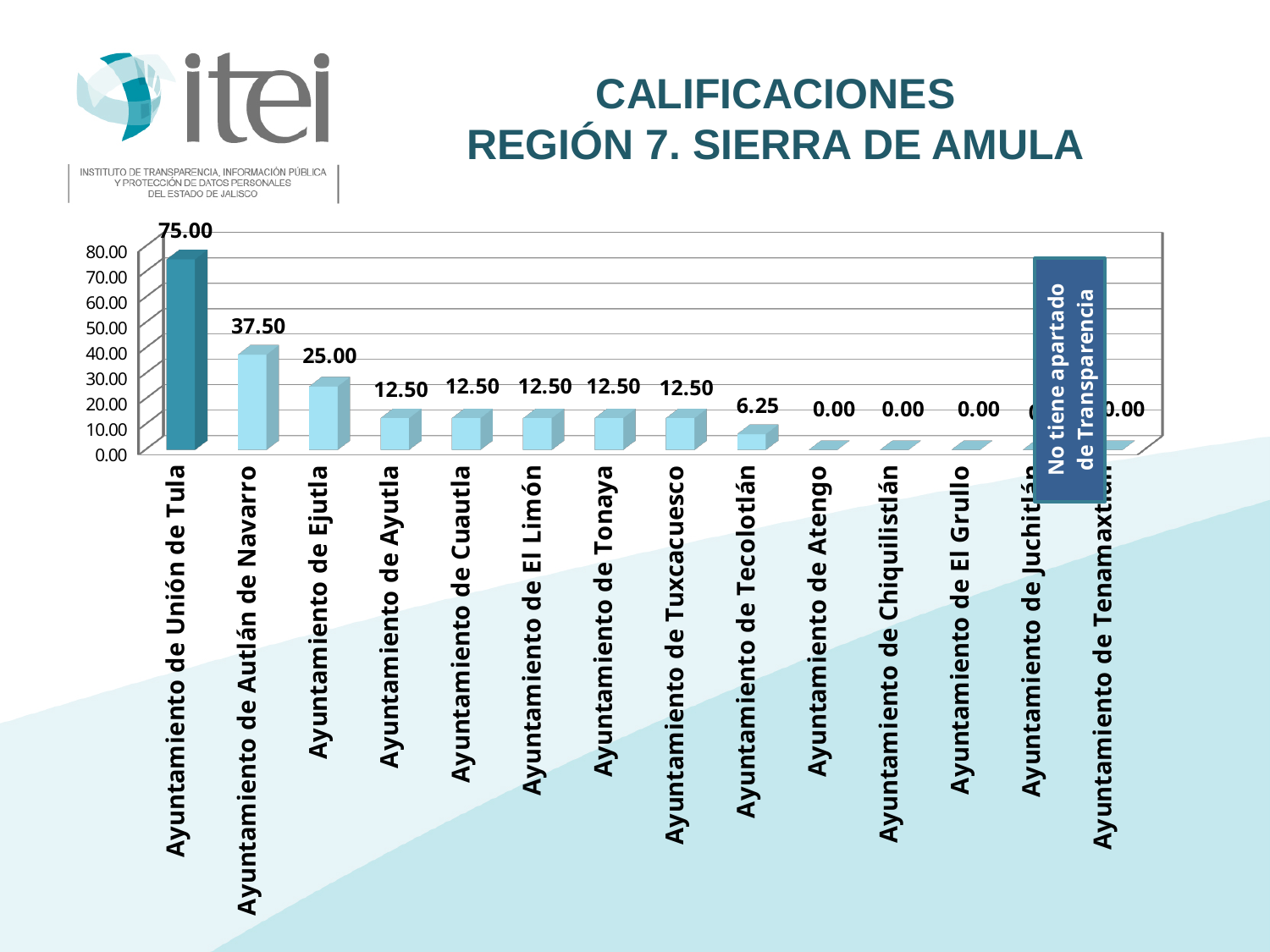
Which municipality has the highest value? Ayuntamiento de Unión de Tula What is the value for Ayuntamiento de Unión de Tula? 75.00 What is the value for Ayuntamiento de Atengo? 0.00 What is the value for Ayuntamiento de Ejutla? 25.00 What kind of chart is shown on the slide? Bar chart What is the difference between the values for Ayuntamiento de Unión de Tula and Ayuntamiento de Autlán de Navarro? 37.50 What does the text box placed over the right side of the chart say? No tiene apartado de Transparencia How many municipalities are shown on the chart? 14 What is the value for Ayuntamiento de Autlán de Navarro? 37.50 Which is larger, the value for Ayuntamiento de Ejutla or the value for Ayuntamiento de Ayutla? Ayuntamiento de Ejutla What is the difference between the values for Ayuntamiento de Ejutla and Ayuntamiento de Tecolotlán? 18.75 What is the value for Ayuntamiento de Tecolotlán? 6.25